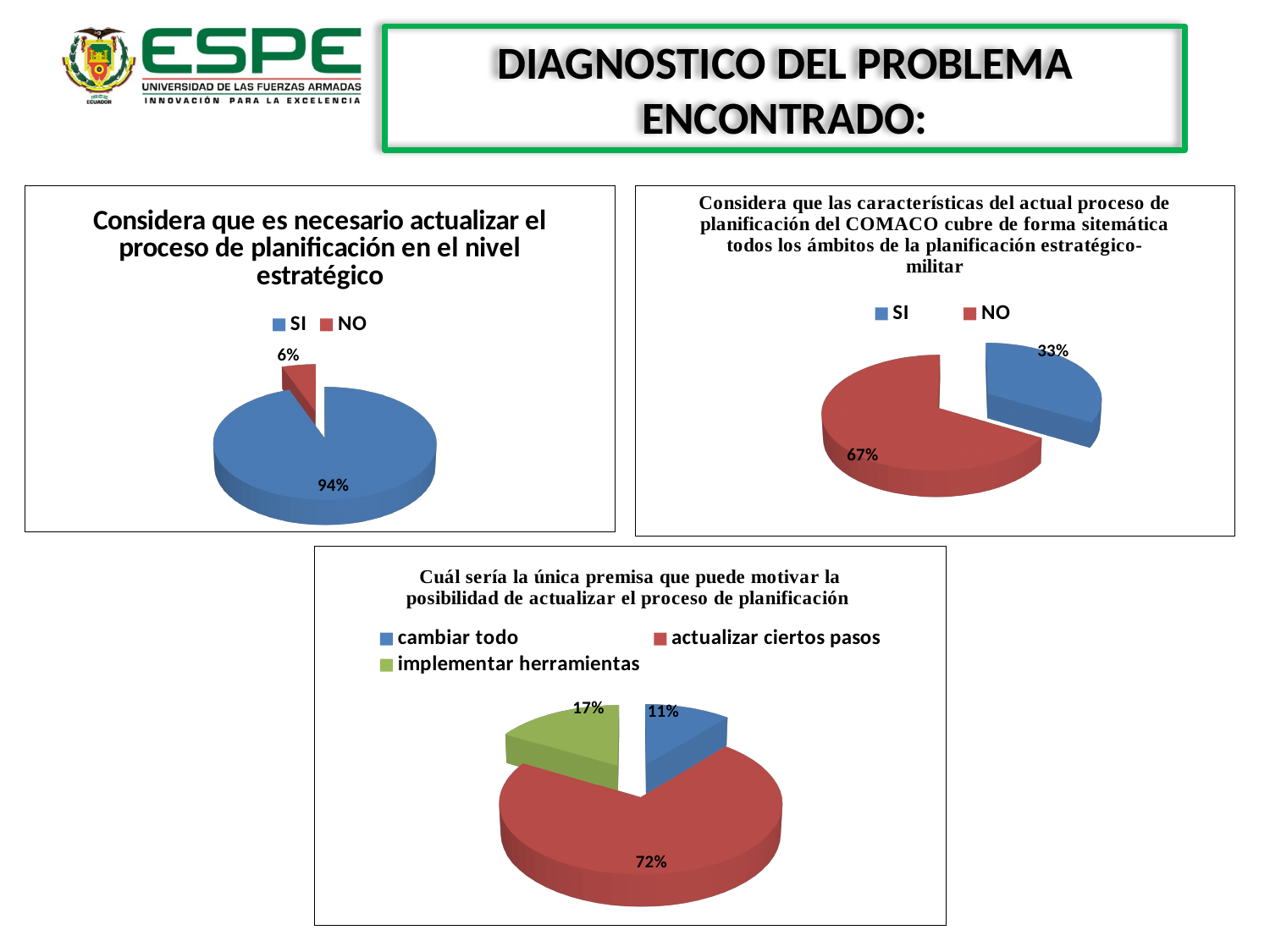
In the bottom chart (Cuál sería la única premisa que puede motivar la posibilidad de actualizar el proceso de planificación), how many categories does the legend list? 3 In the bottom chart (Cuál sería la única premisa que puede motivar la posibilidad de actualizar el proceso de planificación), which category has the smallest share? cambiar todo In the top-left chart (Considera que es necesario actualizar el proceso de planificación en el nivel estratégico), what share of the pie is SI? 94% In the top-left chart (Considera que es necesario actualizar el proceso de planificación en el nivel estratégico), what is the value for NO? 6% In the top-right chart (Considera que las características del actual proceso de planificación del COMACO...), what is the value for NO? 67% In the top-right chart (Considera que las características del actual proceso de planificación del COMACO...), what is the difference between NO and SI? 34% In the bottom chart (Cuál sería la única premisa que puede motivar la posibilidad de actualizar el proceso de planificación), what is the difference between implementar herramientas and cambiar todo? 6% In the bottom chart (Cuál sería la única premisa que puede motivar la posibilidad de actualizar el proceso de planificación), what colour represents implementar herramientas? Green In the top-right chart (Considera que las características del actual proceso de planificación del COMACO...), what is the value for SI? 33% In the top-left chart (Considera que es necesario actualizar el proceso de planificación en el nivel estratégico), what kind of chart is shown? Pie chart In the bottom chart (Cuál sería la única premisa que puede motivar la posibilidad de actualizar el proceso de planificación), what is the value for actualizar ciertos pasos? 72% In the top-right chart (Considera que las características del actual proceso de planificación del COMACO...), which category is larger, SI or NO? NO